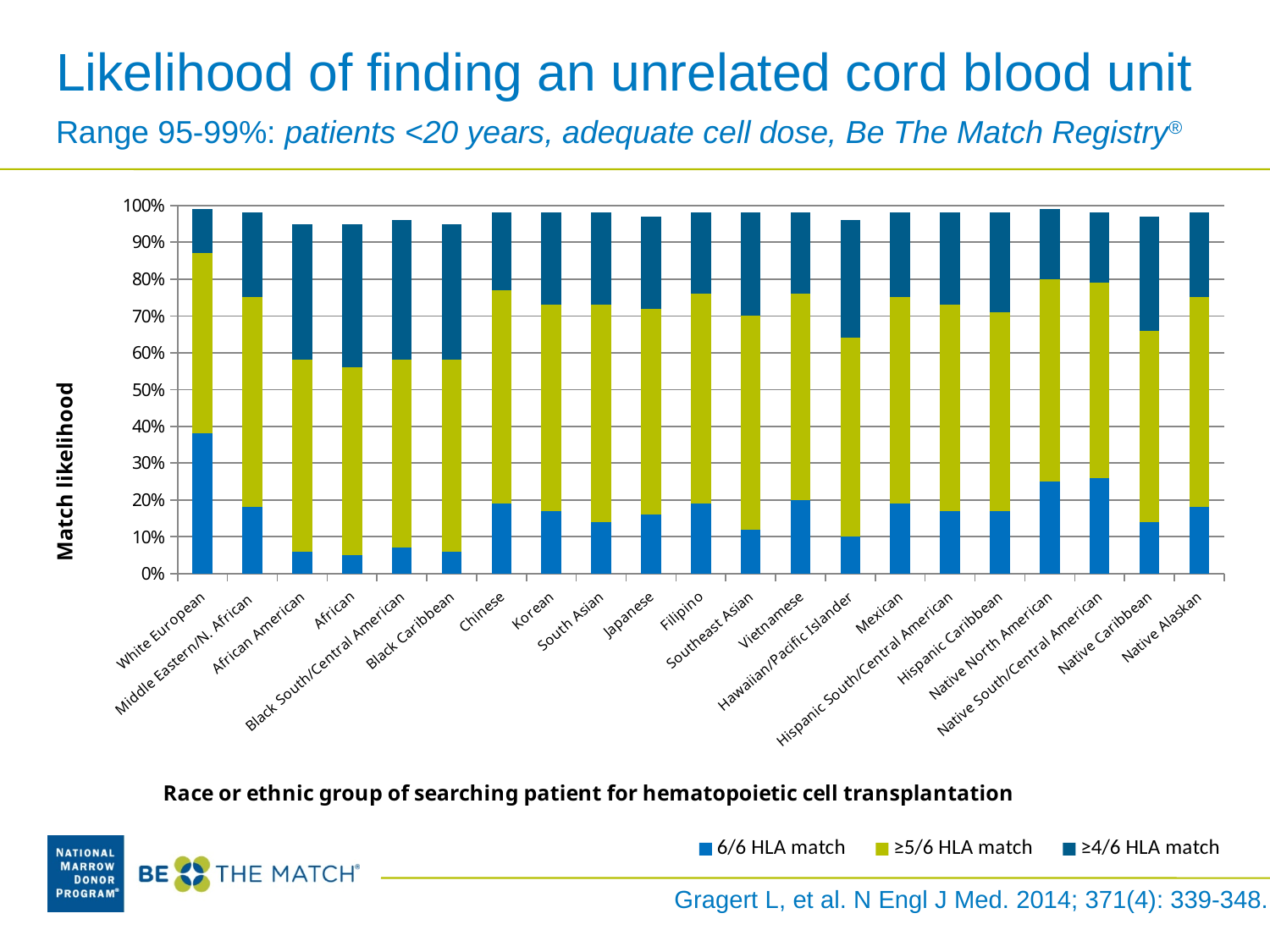
What is the label of the chart's y axis? Match likelihood Which race or ethnic group has the highest 6/6 HLA match likelihood? White European Is the 6/6 HLA match value for African greater or less than 10%? less How many race or ethnic groups are shown along the x axis of the chart? 21 Is the 6/6 HLA match value for Hawaiian/Pacific Islander greater or less than 20%? less Which legend entry is shown in green? ≥5/6 HLA match How many series does the chart's legend list? 3 Which has the larger 6/6 HLA match likelihood, White European or Chinese? White European Is the 6/6 HLA match value for White European greater or less than 30%? greater What kind of chart is shown on the slide? Stacked bar chart Which has the larger 6/6 HLA match likelihood, Native South/Central American or African? Native South/Central American